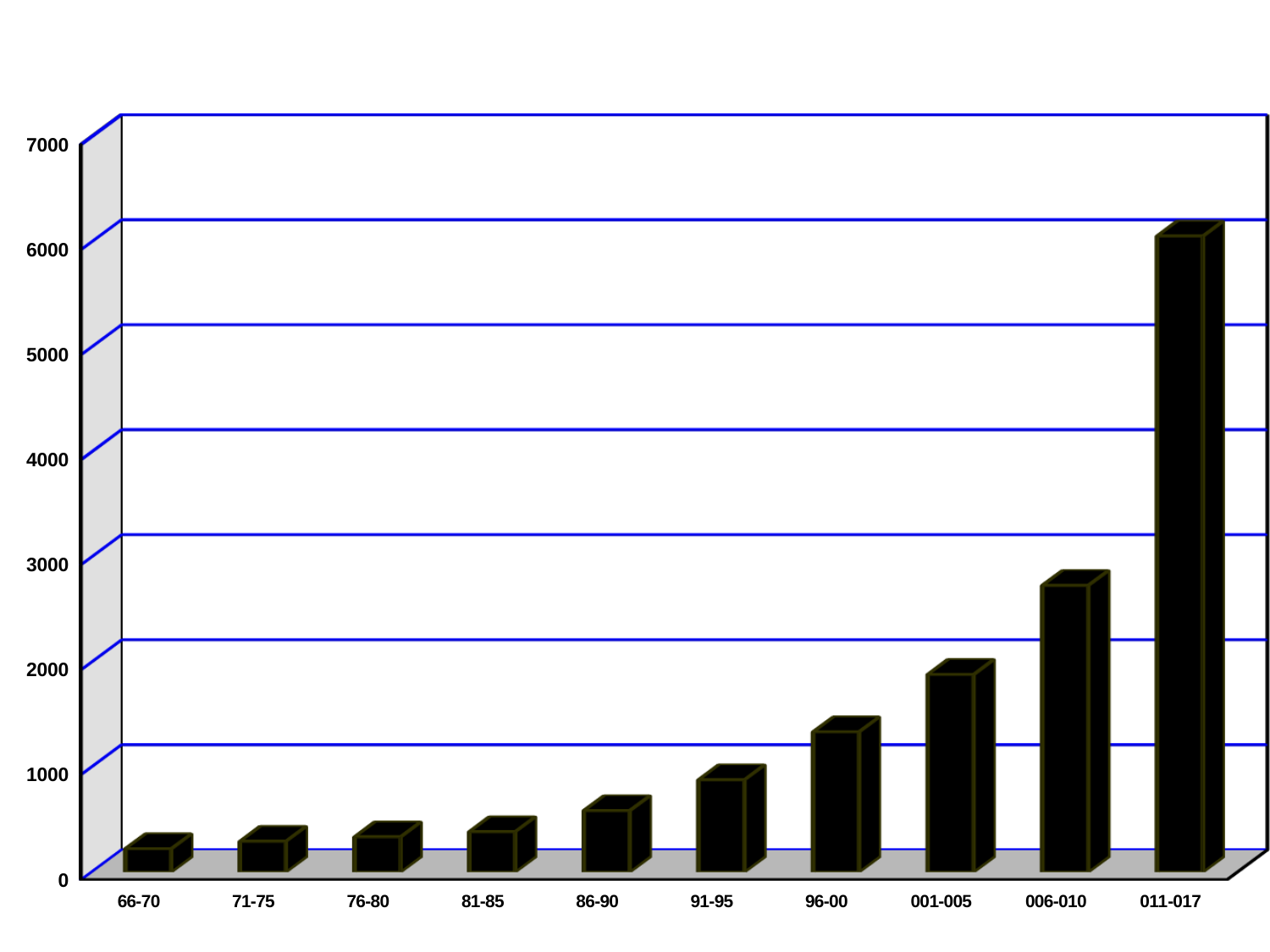
What kind of chart is shown on the slide? bar chart Do the values generally rise or fall from left to right along the x axis? rise Is the value for 86-90 greater or less than 1000? less Which has the larger value, 96-00 or 86-90? 96-00 Is the value for 96-00 greater or less than 1000? greater Is the value for 011-017 greater or less than 5000? greater What is the highest value labelled on the vertical axis? 7000 Which category has the lowest bar? 66-70 How many categories are shown on the x axis? 10 Which category has the highest bar? 011-017 Which has the larger value, 006-010 or 001-005? 006-010